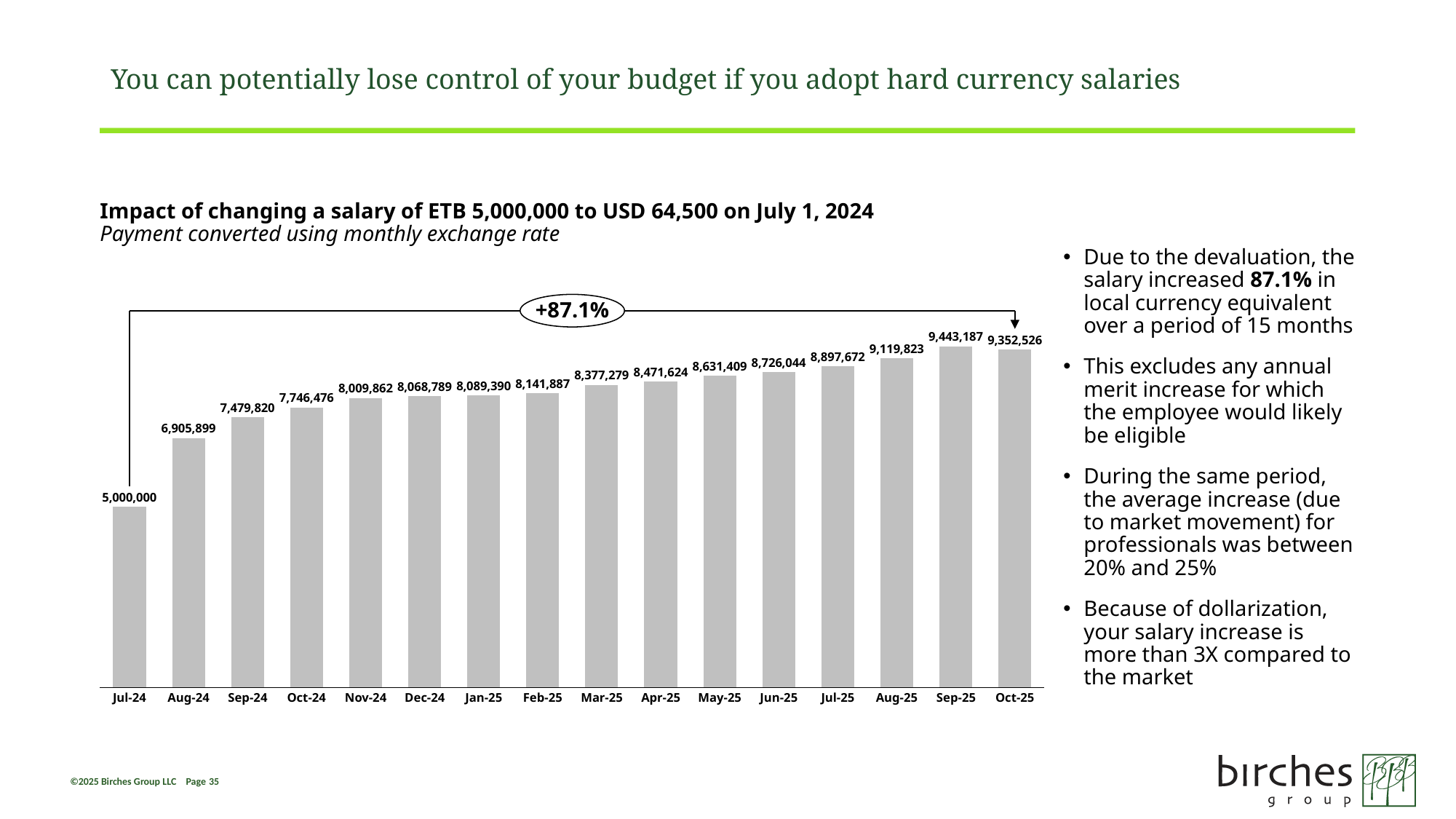
What is the value for Oct-25? 9,352,526 Which month has the highest value? Sep-25 What is the value for Jul-24? 5,000,000 Which is larger, the value for Aug-24 or the value for Sep-24? Sep-24 What is the difference between the values for Oct-25 and Jul-24? 4,352,526 What is the difference between the values for Sep-25 and Oct-25? 90,661 Do the values generally rise or fall from Jul-24 to Sep-25? rise What kind of chart is this? bar chart How many months are shown on the x axis? 16 Which month has the lowest value? Jul-24 What is the value for Jan-25? 8,089,390 What percentage increase is shown in the annotation above the bars? +87.1%